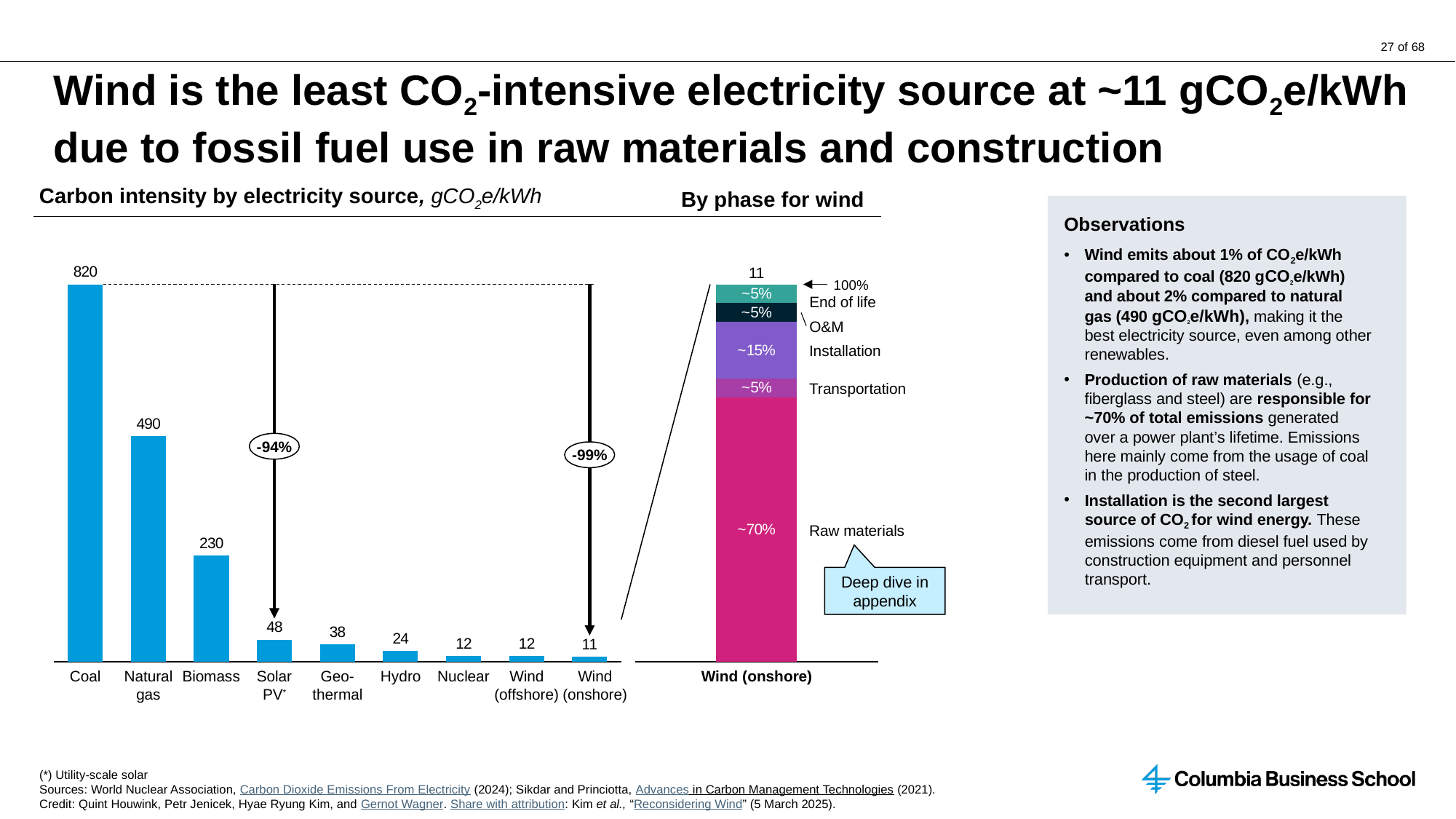
How many electricity sources are shown in the 'Carbon intensity by electricity source' chart? 9 In the 'Carbon intensity by electricity source' chart, which electricity source has the highest carbon intensity? Coal In the 'Carbon intensity by electricity source' chart, what is the difference between the values for Coal and Natural gas? 330 In the 'By phase for wind' chart, what share of emissions comes from Installation? ~15% In the 'By phase for wind' chart, what share of emissions comes from Raw materials? ~70% In the 'Carbon intensity by electricity source' chart, what is the value for Biomass? 230 In the 'Carbon intensity by electricity source' chart, which electricity source has the lowest carbon intensity? Wind (onshore) In the 'Carbon intensity by electricity source' chart, what is the value for Coal? 820 In the 'Carbon intensity by electricity source' chart, do the values rise or fall from left to right along the x axis? Fall In the 'Carbon intensity by electricity source' chart, what is the value for Hydro? 24 In the 'Carbon intensity by electricity source' chart, which is larger, the value for Solar PV or the value for Geothermal? Solar PV What kind of chart is the 'Carbon intensity by electricity source' chart? Bar chart